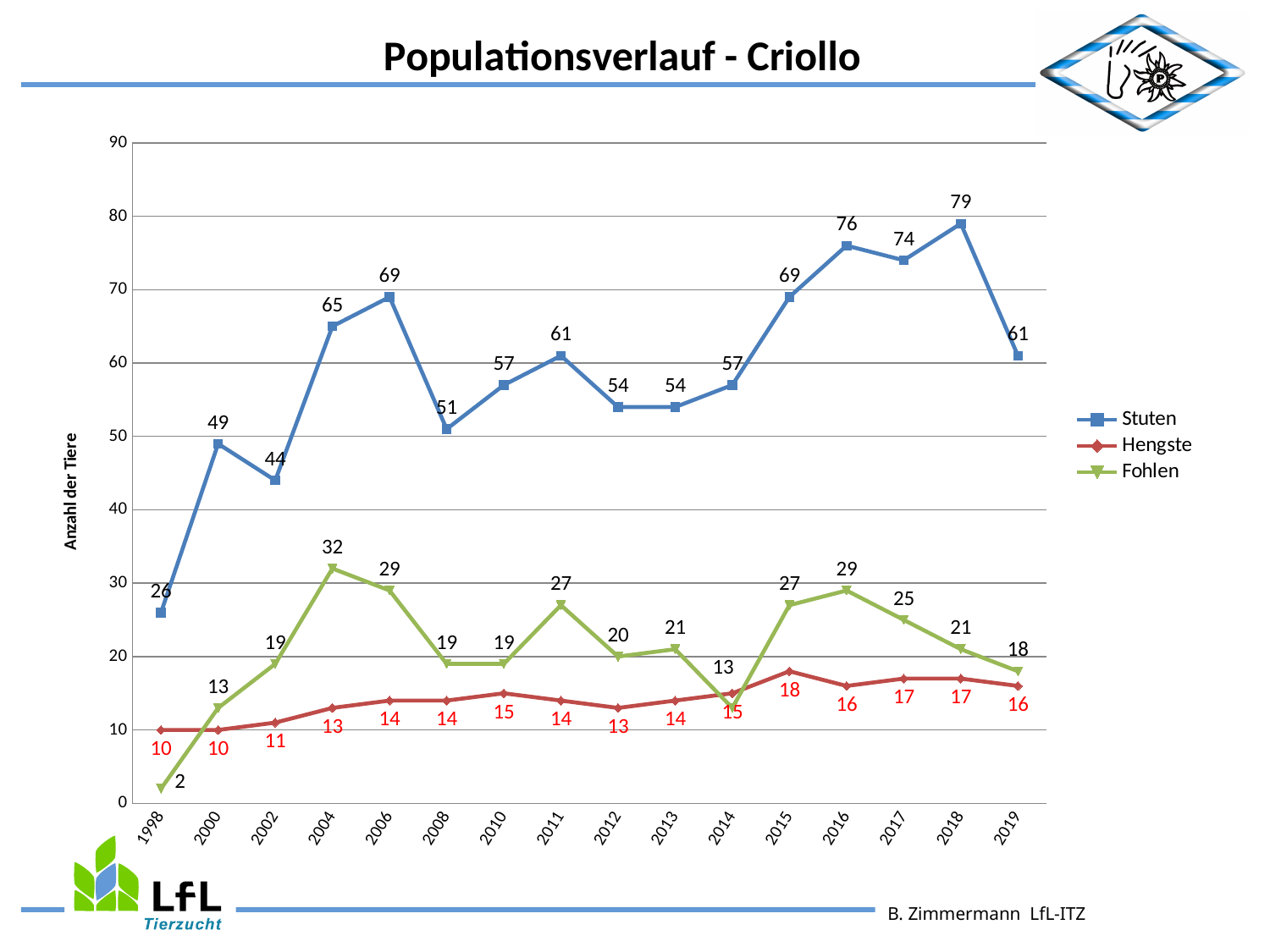
Do the Stuten values rise or fall from 2013 to 2016? rise In which year is the Stuten value highest? 2018 What is the label of the y axis? Anzahl der Tiere What kind of chart is shown on the slide? line chart What is the difference between the Stuten values in 2016 and 2019? 15 In which year is the Fohlen value lowest? 1998 What is the value for Hengste in 2015? 18 How many years are shown on the x axis? 16 What is the value for Fohlen in 2004? 32 What is the value for Stuten in 2018? 79 Which year has the larger Fohlen value, 2004 or 2006? 2004 How many series does the legend list? 3